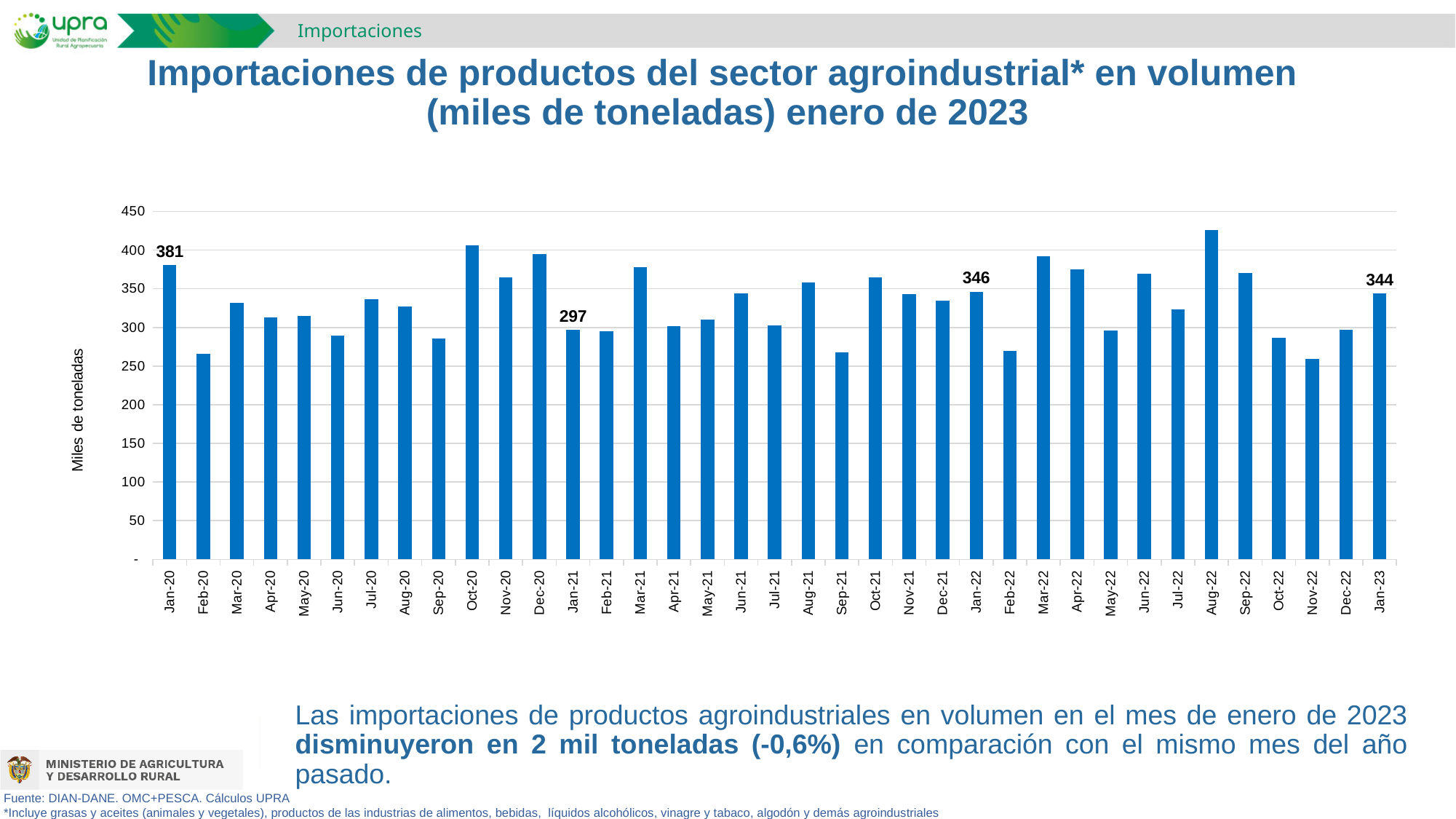
What is the difference between the values for Jan-20 and Jan-21? 84 What type of chart is shown on the slide? Bar chart Is the value for Oct-20 greater or less than 400? greater What is the value for Jan-21? 297 Is the value for Feb-20 greater or less than 300? less What is the difference between the values for Jan-22 and Jan-23? 2 What is the value for Jan-20? 381 What is the value for Jan-22? 346 What is the value for Jan-23? 344 How many monthly bars are plotted in the chart? 37 Which is larger, the value for Jan-20 or the value for Jan-21? Jan-20 Which month has the highest bar in the chart? Aug-22